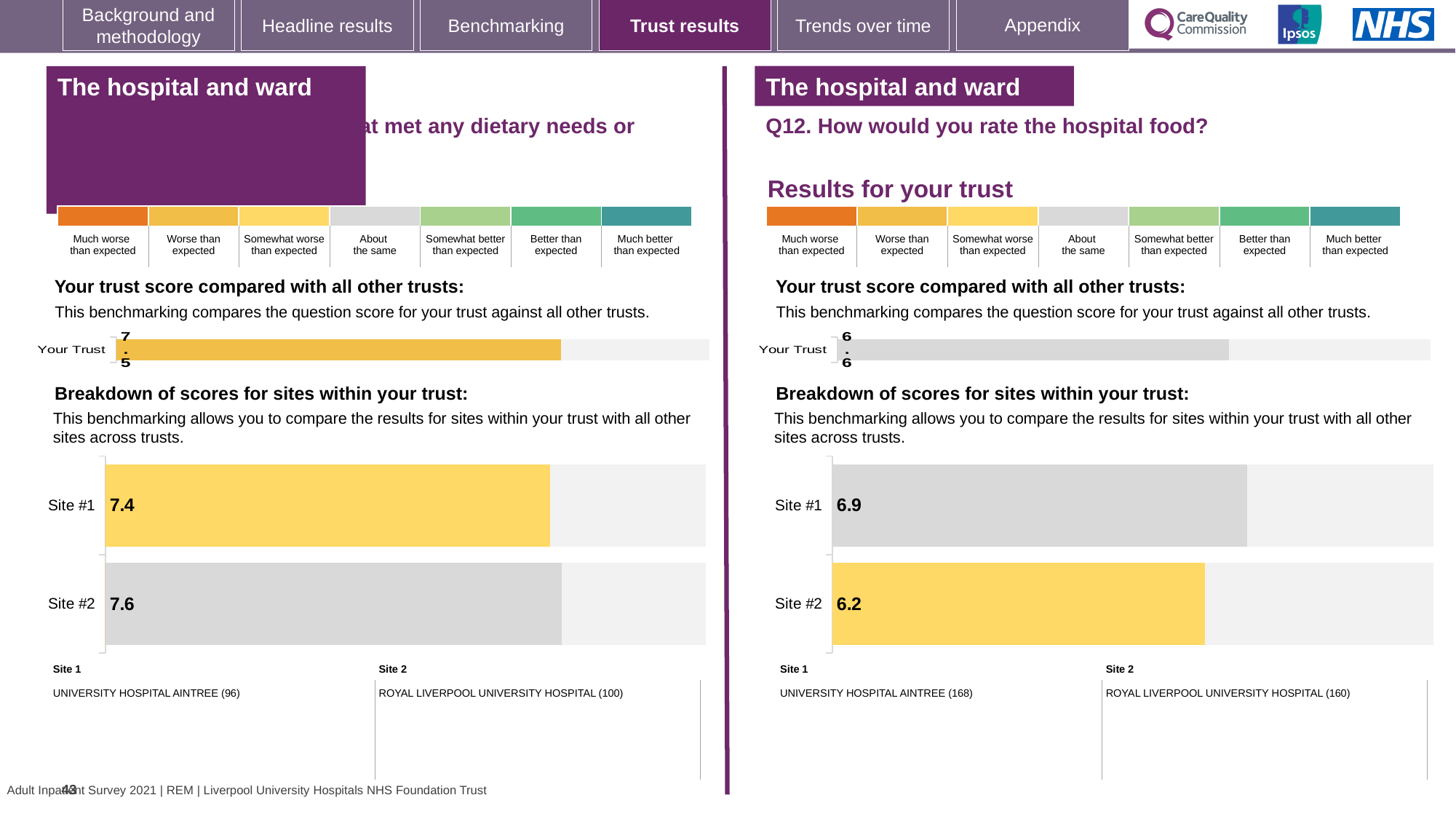
In the right-hand (Q12 hospital food) site breakdown chart, which site has the higher score? Site #1 In the left-hand 'Your trust score compared with all other trusts' chart, what is the score for Your Trust? 7.5 What type of chart is the right-hand (Q12 hospital food) site breakdown chart? Bar chart In the right-hand (Q12 hospital food) site breakdown chart, what is the difference between the Site #1 and Site #2 scores? 0.7 In the right-hand (Q12 hospital food) site breakdown chart, what is the score for Site #1? 6.9 In the left-hand site breakdown chart, what is the score for Site #1? 7.4 In the left-hand site breakdown chart, which site has the lower score? Site #1 In the left-hand site breakdown chart, what is the score for Site #2? 7.6 How many sites are shown in the right-hand (Q12 hospital food) site breakdown chart? 2 In the right-hand (Q12 hospital food) site breakdown chart, what is the score for Site #2? 6.2 In the left-hand site breakdown chart, what is the difference between the Site #2 and Site #1 scores? 0.2 In the right-hand (Q12 hospital food) 'Your trust score compared with all other trusts' chart, what is the score for Your Trust? 6.6